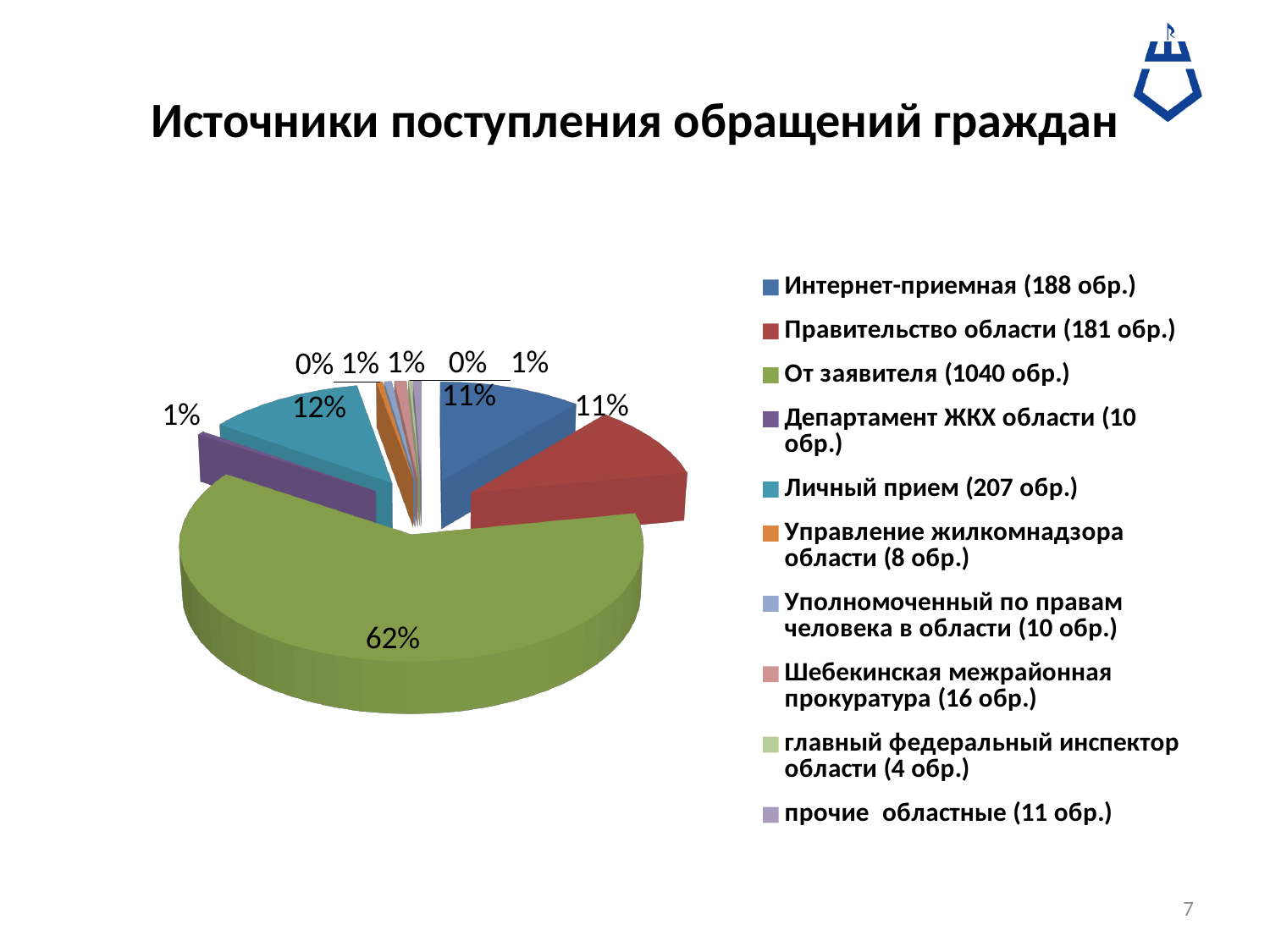
According to the legend, how many appeals (обр.) came from "Интернет-приемная"? 188 обр. What share of the pie does "Правительство области" account for? 11% How many categories does the legend of the pie chart list? 10 What kind of chart is shown on the slide? pie chart What share of the pie does "Интернет-приемная" account for? 11% What is the title of the chart? Источники поступления обращений граждан Which category has the largest slice of the pie? От заявителя What share of the pie does "Личный прием" account for? 12% Which is larger: the slice for "Личный прием" or the slice for "Интернет-приемная"? Личный прием What is the difference in percentage points between the "От заявителя" slice and the "Личный прием" slice? 50%